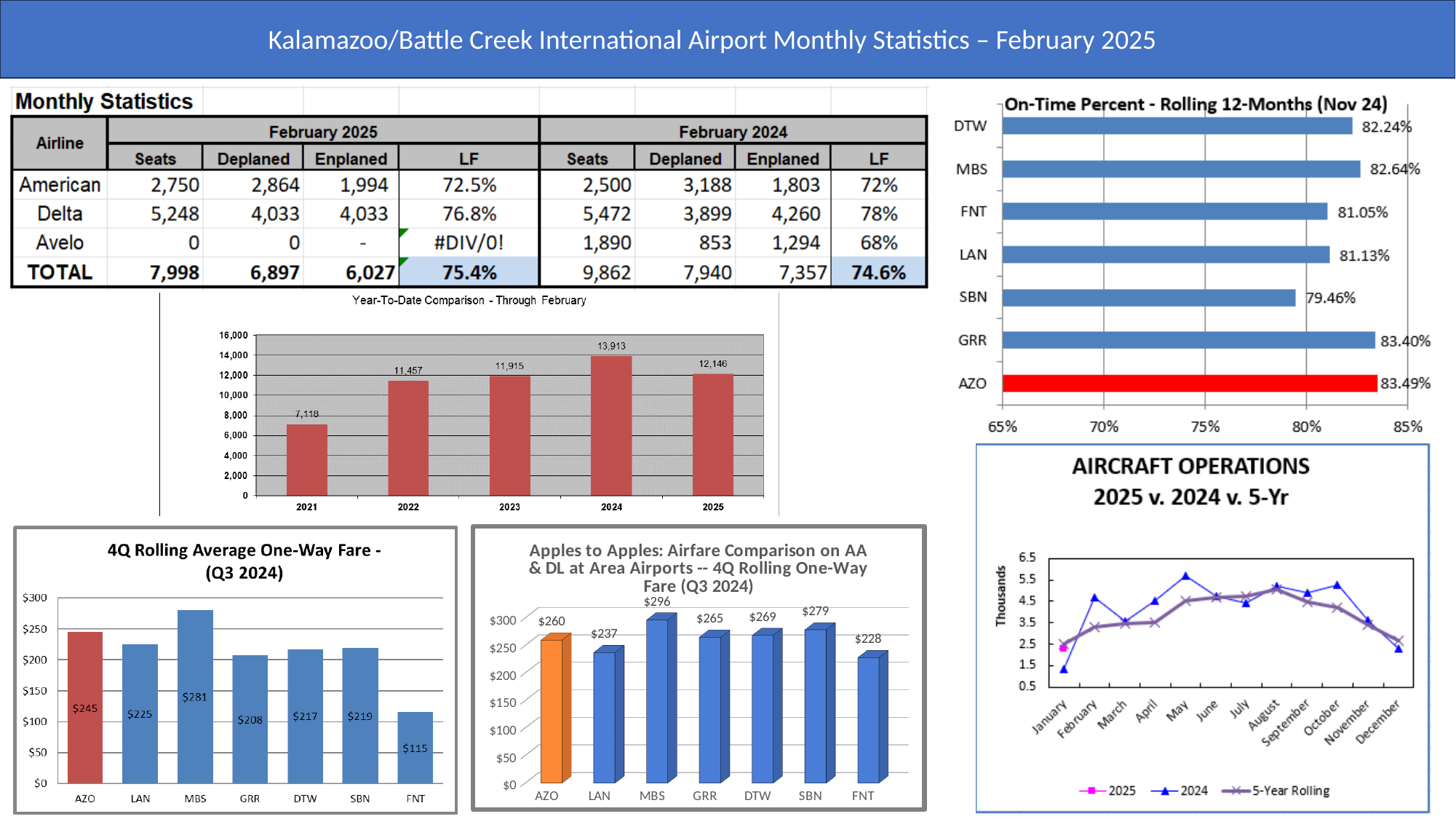
In the Apples to Apples airfare comparison chart, what is the difference between the AZO and LAN fares? $23 What kind of chart is the Aircraft Operations chart? line chart In the On-Time Percent - Rolling 12-Months chart, what is the value for AZO? 83.49% How many series does the legend of the Aircraft Operations chart list? 3 In the Year-To-Date Comparison chart, what is the value for 2024? 13,913 In the 4Q Rolling Average One-Way Fare chart, what is the fare for MBS? $281 In the Year-To-Date Comparison chart, what is the difference between the 2024 and 2025 values? 1,767 In the Year-To-Date Comparison chart, which year has the highest value? 2024 In the Year-To-Date Comparison chart, do the values rise or fall from 2021 to 2024? rise How many airports are shown in the On-Time Percent - Rolling 12-Months chart? 7 In the On-Time Percent - Rolling 12-Months chart, which airport has the lowest on-time percent? SBN In the 4Q Rolling Average One-Way Fare chart, which airport has the lowest fare? FNT